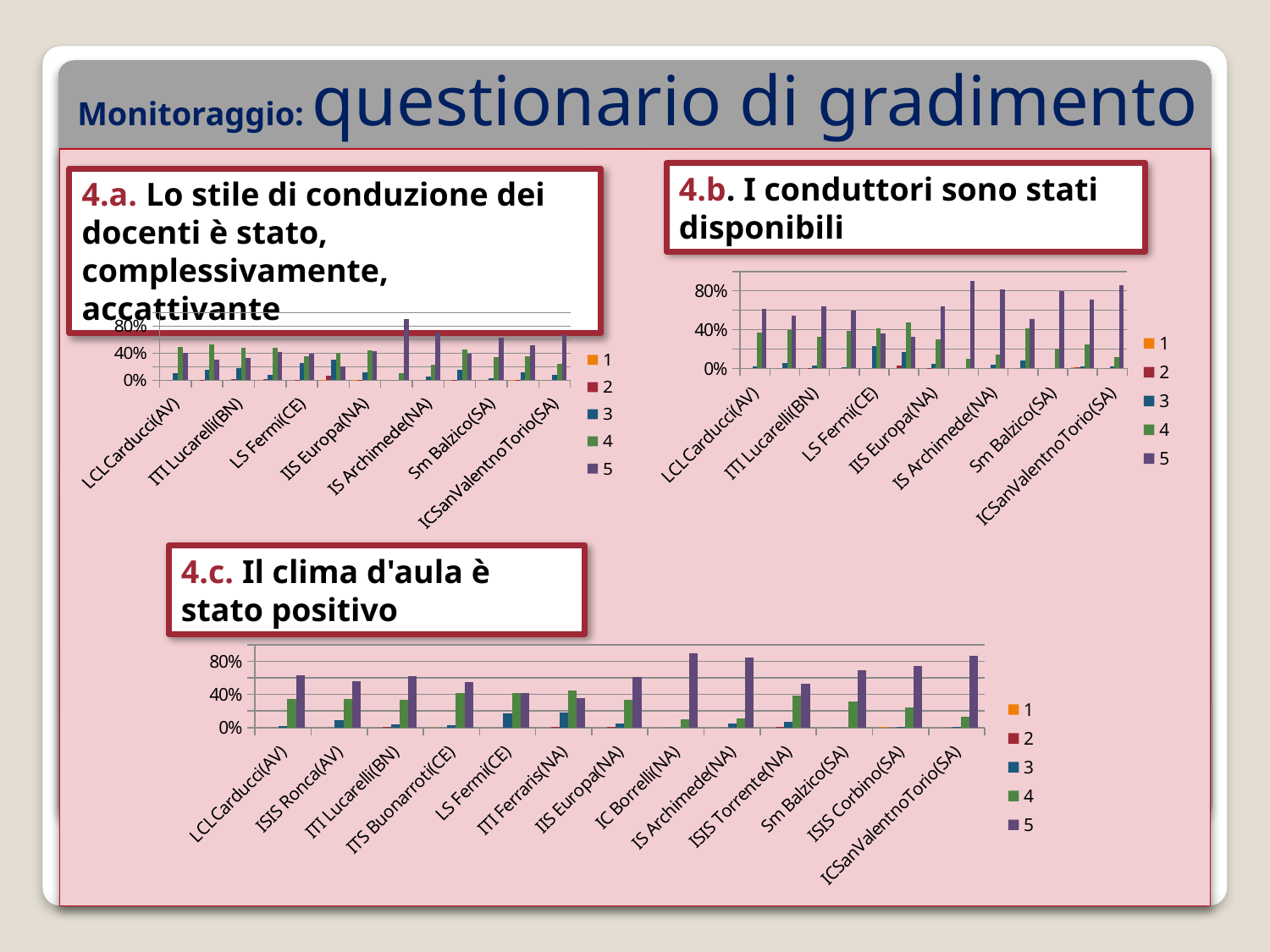
What are the legend entries of the chart titled "4.a. Lo stile di conduzione dei docenti è stato, complessivamente, accattivante"? 1, 2, 3, 4, 5 What is the title of the chart in the top right of the slide? 4.b. I conduttori sono stati disponibili How many categories are shown on the x axis of the chart titled "4.c. Il clima d'aula è stato positivo"? 13 In the chart titled "4.b. I conduttori sono stati disponibili", is the value of series 5 for LCLCarducci(AV) greater or less than 40%? greater In the chart titled "4.c. Il clima d'aula è stato positivo", which series has the highest bar for IC Borrelli(NA)? 5 How many series does the legend list in the chart titled "4.b. I conduttori sono stati disponibili"? 5 In the chart titled "4.c. Il clima d'aula è stato positivo", for ITI Ferraris(NA), which is larger: series 4 or series 5? 4 What kind of chart is the chart titled "4.c. Il clima d'aula è stato positivo"? bar chart In the chart titled "4.c. Il clima d'aula è stato positivo", is the value of series 5 for IC Borrelli(NA) greater or less than 80%? greater In the chart titled "4.c. Il clima d'aula è stato positivo", is the value of series 4 for LCLCarducci(AV) greater or less than 40%? less In the chart titled "4.c. Il clima d'aula è stato positivo", for IIS Europa(NA), which is larger: series 4 or series 5? 5